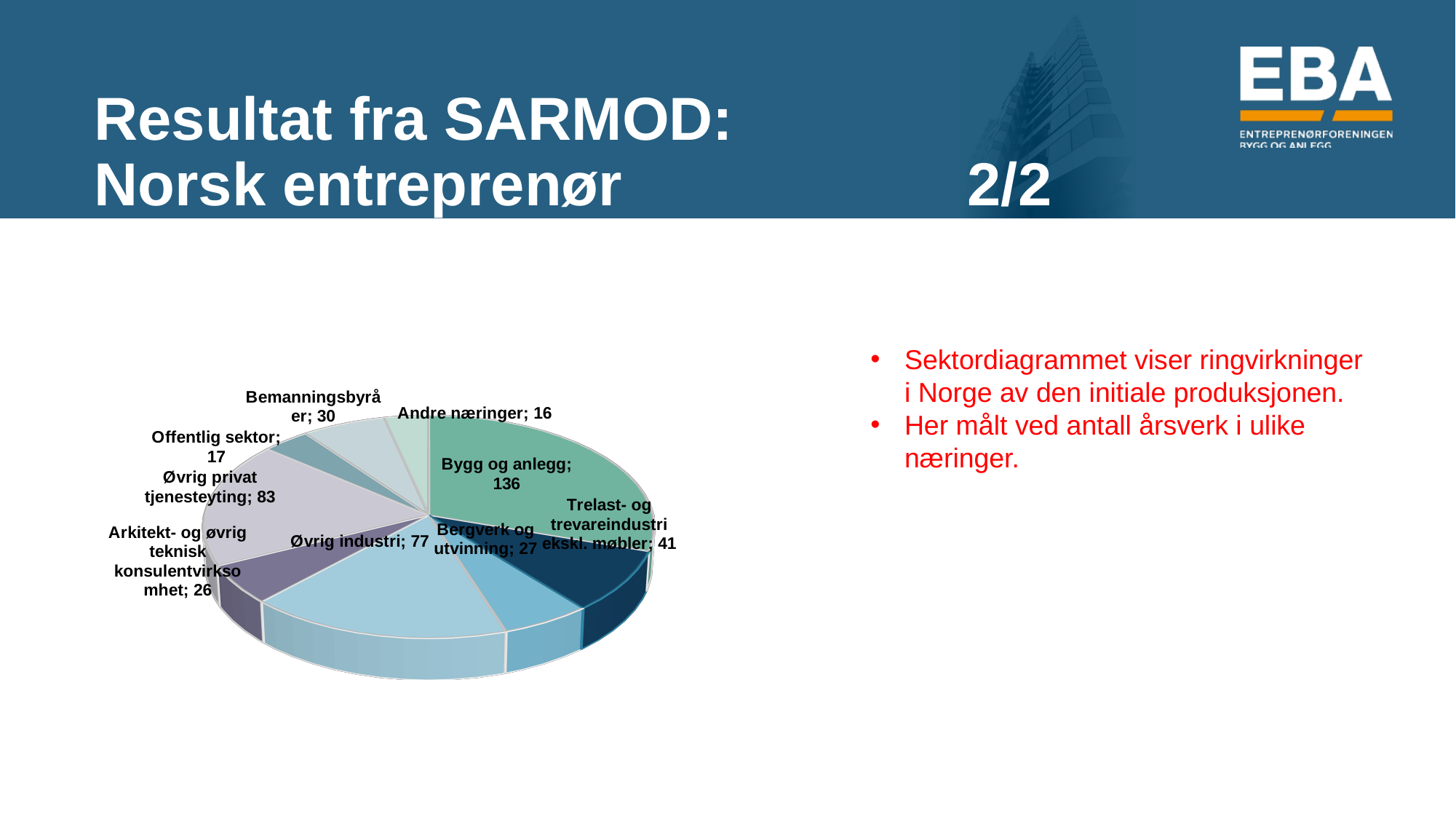
Which is larger, Øvrig privat tjenesteyting or Øvrig industri? Øvrig privat tjenesteyting How many slices does the pie chart have? 9 What is the total of all the values shown in the pie chart? 453 What share of the pie does Bygg og anlegg represent? 30% What is the value for Øvrig privat tjenesteyting? 83 What is the difference between the values for Bygg og anlegg and Øvrig industri? 59 What is the value for Bygg og anlegg? 136 Which category has the largest slice in the pie chart? Bygg og anlegg What is the value for Bemanningsbyråer? 30 What is the value for Trelast- og trevareindustri ekskl. møbler? 41 What type of chart is shown on the slide? Pie chart Which category has the smallest slice in the pie chart? Andre næringer